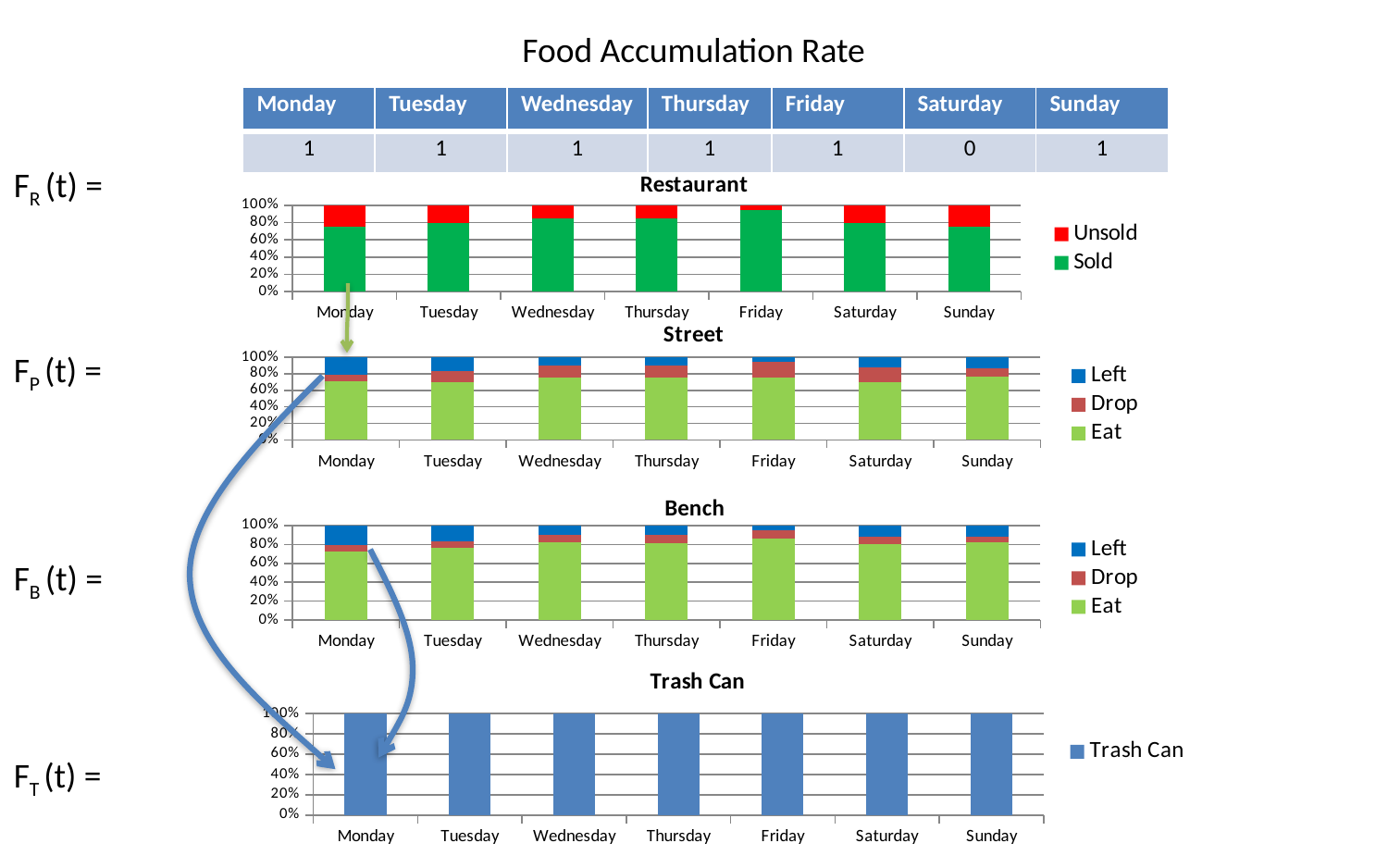
What kind of chart is the Restaurant chart? stacked bar chart How many series does the legend of the Restaurant chart list? 2 In the Restaurant chart, is the Sold value for Friday greater or less than 80%? greater In the Restaurant chart, is the Sold value for Monday greater or less than 80%? less In the Restaurant chart, which day has the highest Sold share? Friday How many series does the legend of the Street chart list? 3 In the Bench chart, is the Eat value for Monday greater or less than 80%? less In the Restaurant chart, which day has the lowest Unsold share? Friday In the Bench chart, which day has the largest Left share? Monday What colour represents Unsold in the Restaurant chart? red How many categories are shown on the x axis of the Trash Can chart? 7 In the Trash Can chart, what value does each bar reach? 100%